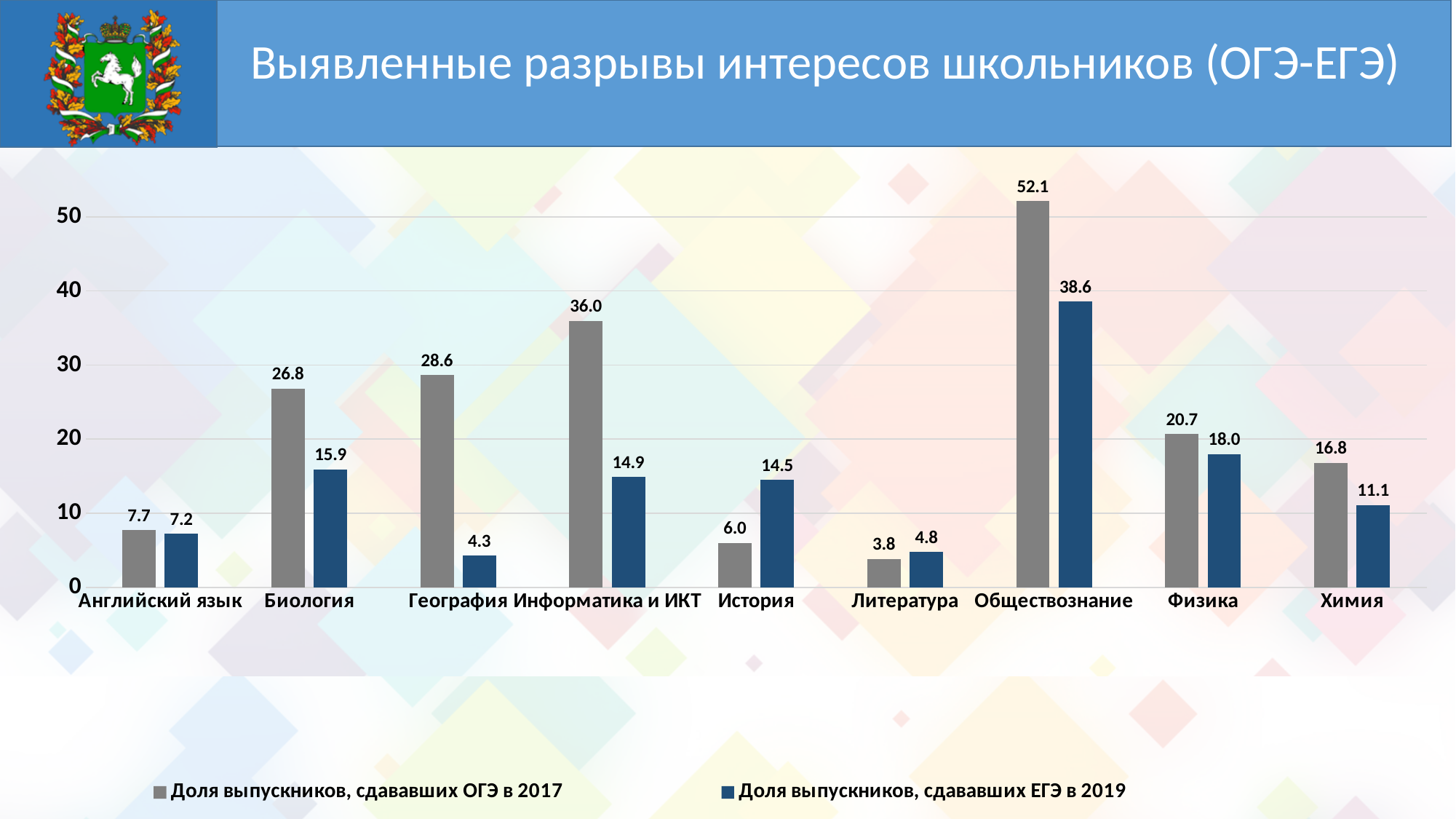
Which category has the highest value in the series 'Доля выпускников, сдававших ОГЭ в 2017'? Обществознание What is the title of the slide? Выявленные разрывы интересов школьников (ОГЭ-ЕГЭ) What is the value for География in the series 'Доля выпускников, сдававших ЕГЭ в 2019'? 4.3 How many series does the legend list? 2 What is the value for Обществознание in the series 'Доля выпускников, сдававших ОГЭ в 2017'? 52.1 What kind of chart is shown on the slide? bar chart What is the difference between the 2017 ОГЭ value and the 2019 ЕГЭ value for Информатика и ИКТ? 21.1 How many categories are shown on the x axis of the chart? 9 What is the value for Физика in the series 'Доля выпускников, сдававших ЕГЭ в 2019'? 18.0 Is the value for Биология in the series 'Доля выпускников, сдававших ОГЭ в 2017' greater or less than 20? greater For Литература, which series has the larger value: 'Доля выпускников, сдававших ОГЭ в 2017' or 'Доля выпускников, сдававших ЕГЭ в 2019'? Доля выпускников, сдававших ЕГЭ в 2019 Which category has the lowest value in the series 'Доля выпускников, сдававших ЕГЭ в 2019'? География